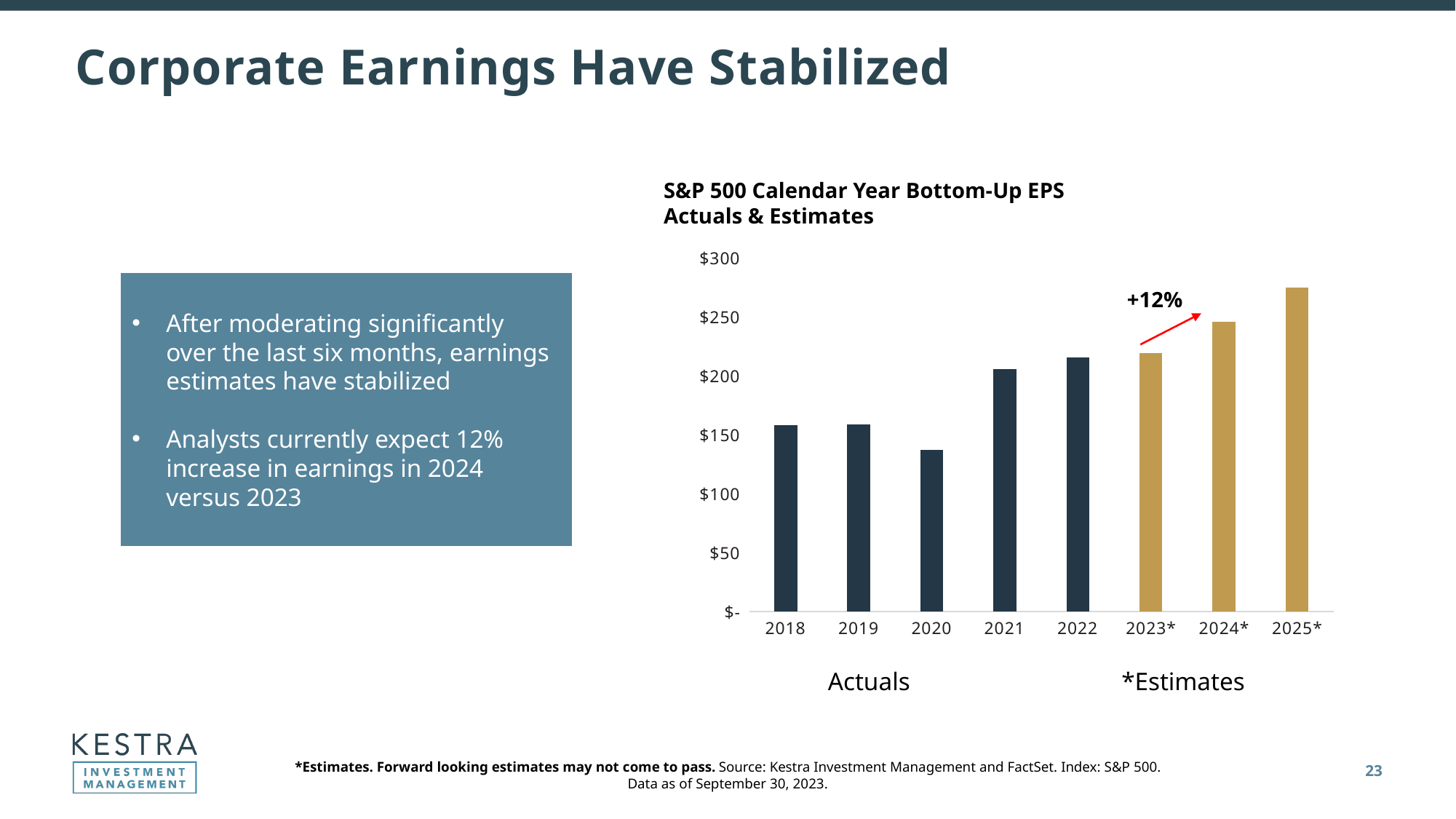
Is the value for 2018 greater or less than $200? less Which year has the highest bar in the chart? 2025* How many years are shown on the x axis of the chart? 8 Is the value for 2025* greater or less than $250? greater Which year has the lowest bar in the chart? 2020 What kind of chart is shown on the slide? bar chart Is the value for 2020 greater or less than $150? less Do the values rise or fall from 2020 to 2025*? rise What two categories does the chart's legend list? Actuals and *Estimates Which is larger, the value for 2021 or the value for 2020? 2021 What percentage increase is annotated between the 2023* and 2024* bars? +12%